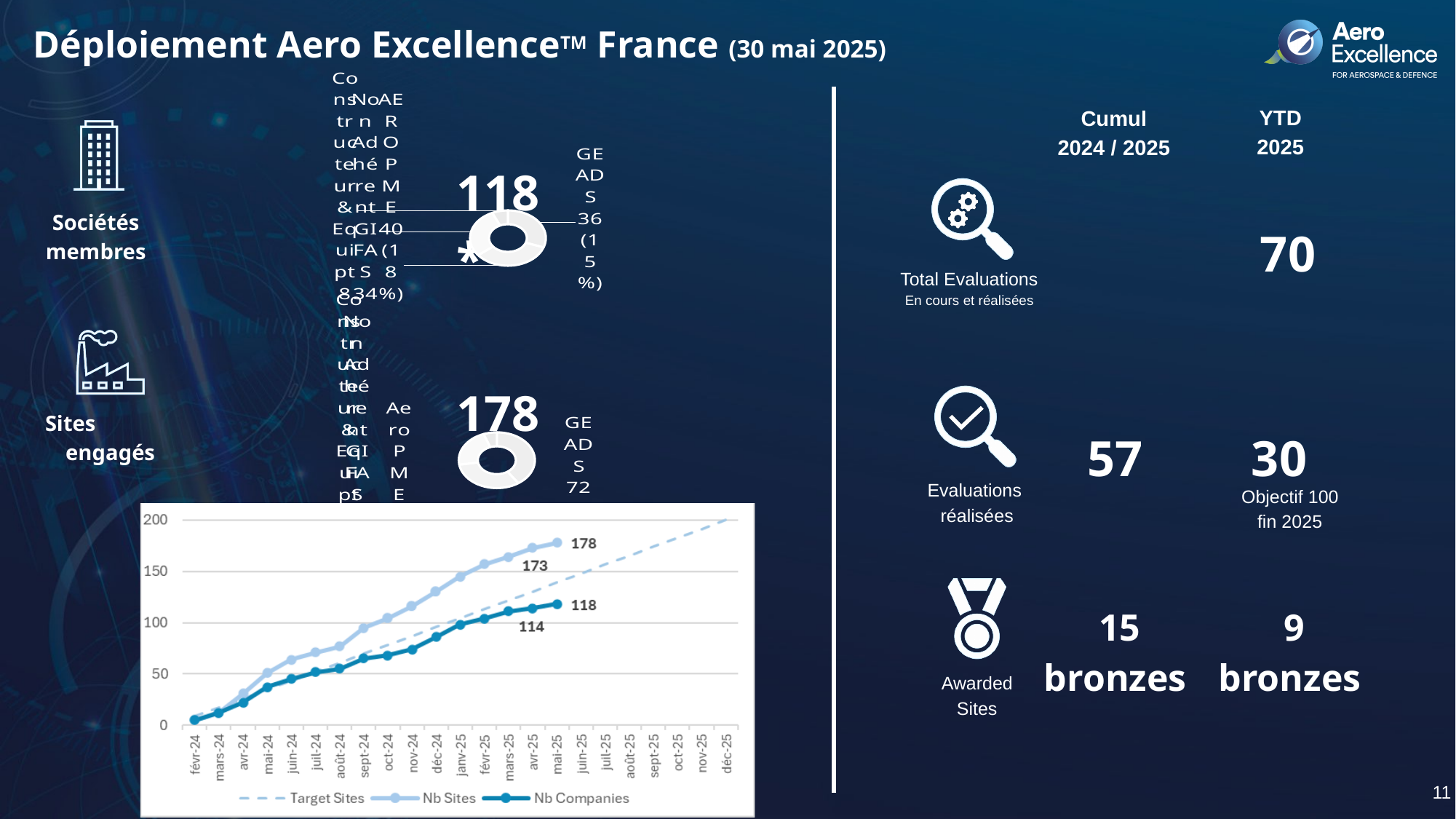
In the bottom-left line chart, is the value for Nb Companies at oct-24 greater or less than 100? less In the bottom-left line chart, which is larger at mai-25: Nb Sites or Nb Companies? Nb Sites What number is shown in the centre of the upper donut chart next to 'Sociétés membres'? 118 What kind of chart is shown at the bottom left of the slide? line chart In the bottom-left line chart, what is the value of Nb Sites at mai-25? 178 In the bottom-left line chart, how many months are shown on the x axis? 23 In the bottom-left line chart, what is the difference between Nb Sites and Nb Companies at mai-25? 60 In the bottom-left line chart, does the Nb Sites series rise or fall from févr-24 to mai-25? rise In the bottom-left line chart, which series is drawn with a dashed line? Target Sites In the bottom-left line chart, what is the value of Nb Companies at mai-25? 118 In the bottom-left line chart, is the value for Nb Sites at janv-25 greater or less than 100? greater In the bottom-left line chart, how many series does the legend list? 3